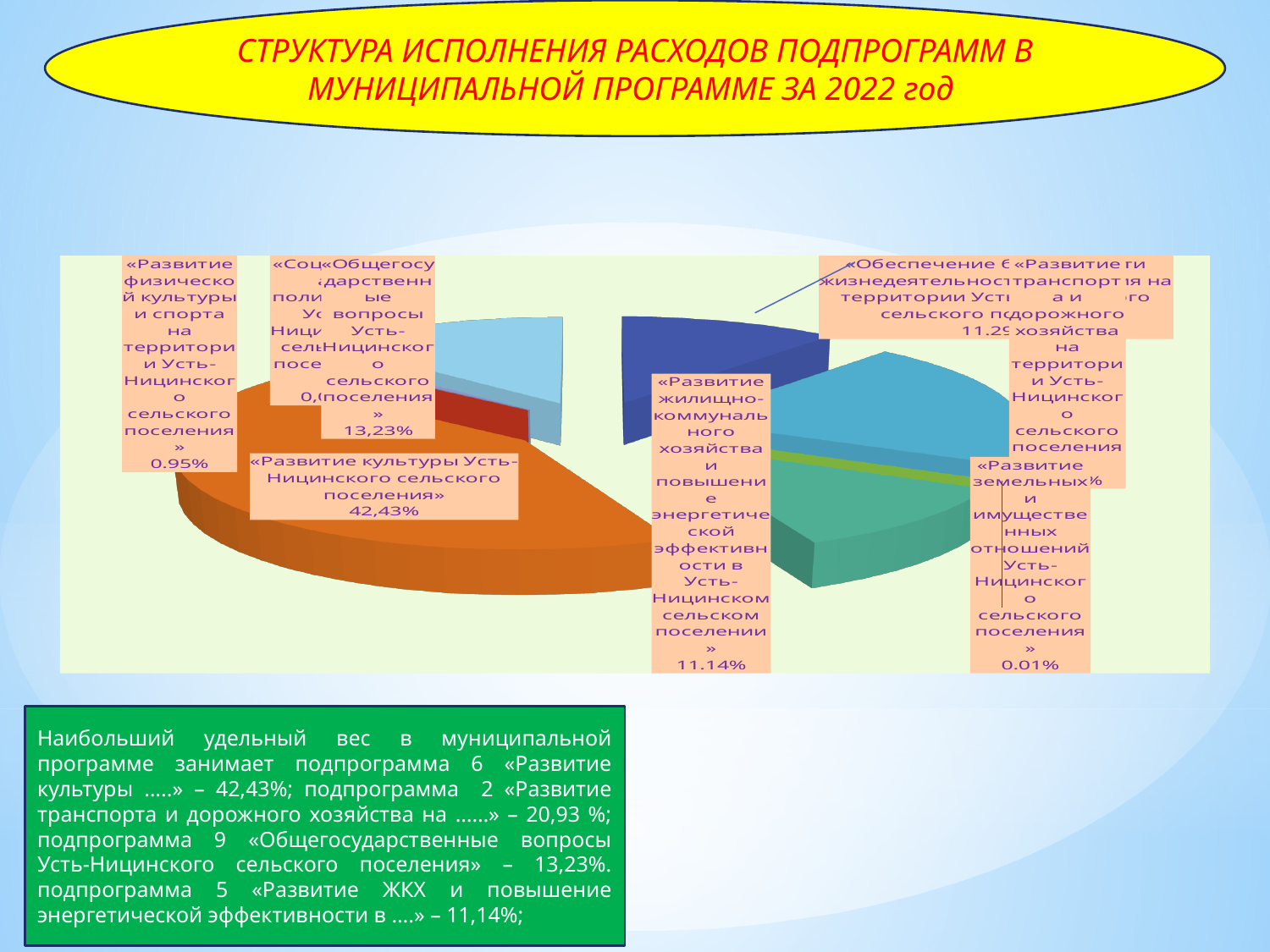
What is the title of the slide's chart? СТРУКТУРА ИСПОЛНЕНИЯ РАСХОДОВ ПОДПРОГРАММ В МУНИЦИПАЛЬНОЙ ПРОГРАММЕ ЗА 2022 год What share is shown for «Развитие земельных и имущественных отношений Усть-Ницинского сельского поселения»? 0.01% Which subprogram has the smallest share in the pie chart? «Развитие земельных и имущественных отношений Усть-Ницинского сельского поселения» What share does the subprogram «Развитие культуры Усть-Ницинского сельского поселения» have in the pie chart? 42,43% Which has the larger share: «Общегосударственные вопросы...» or «Развитие жилищно-коммунального хозяйства...»? «Общегосударственные вопросы...» Is the share of «Развитие культуры Усть-Ницинского сельского поселения» greater or less than 40%? greater What kind of chart is shown on the slide? Pie chart Which subprogram has the largest share in the pie chart? «Развитие культуры Усть-Ницинского сельского поселения» What share is shown for «Развитие физической культуры и спорта на территории Усть-Ницинского сельского поселения»? 0.95% By how many percentage points does the share of «Развитие культуры...» exceed the share of «Общегосударственные вопросы...»? 29,20% What share is shown for «Общегосударственные вопросы Усть-Ницинского сельского поселения»? 13,23% What share is shown for the subprogram on housing and communal services and energy efficiency («Развитие жилищно-коммунального хозяйства и повышение энергетической эффективности...»)? 11.14%